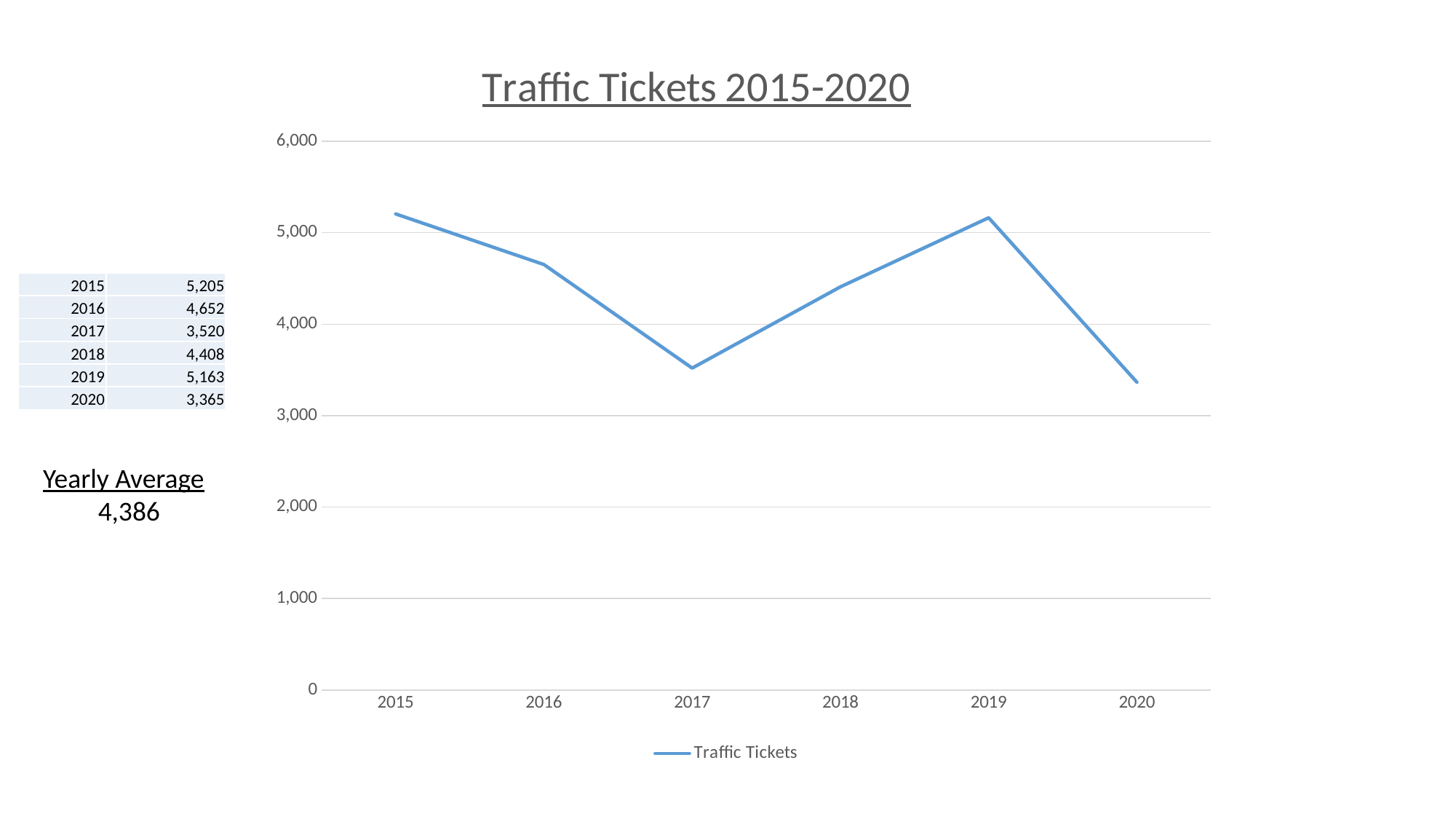
What is the value for 2019 in the Traffic Tickets 2015-2020 chart? 5,163 Do the traffic ticket values rise or fall from 2019 to 2020? fall Is the value for 2018 greater or less than 4,000? greater How many series does the legend list? 1 Which year has the highest number of traffic tickets? 2015 What is the value for 2017 in the Traffic Tickets 2015-2020 chart? 3,520 What type of chart is shown on the slide? line chart How many years are plotted on the x axis of the chart? 6 What is the difference between the traffic tickets in 2015 and 2020? 1,840 Which year had more traffic tickets, 2016 or 2018? 2016 What is the title of the chart? Traffic Tickets 2015-2020 Which year has the lowest number of traffic tickets? 2020